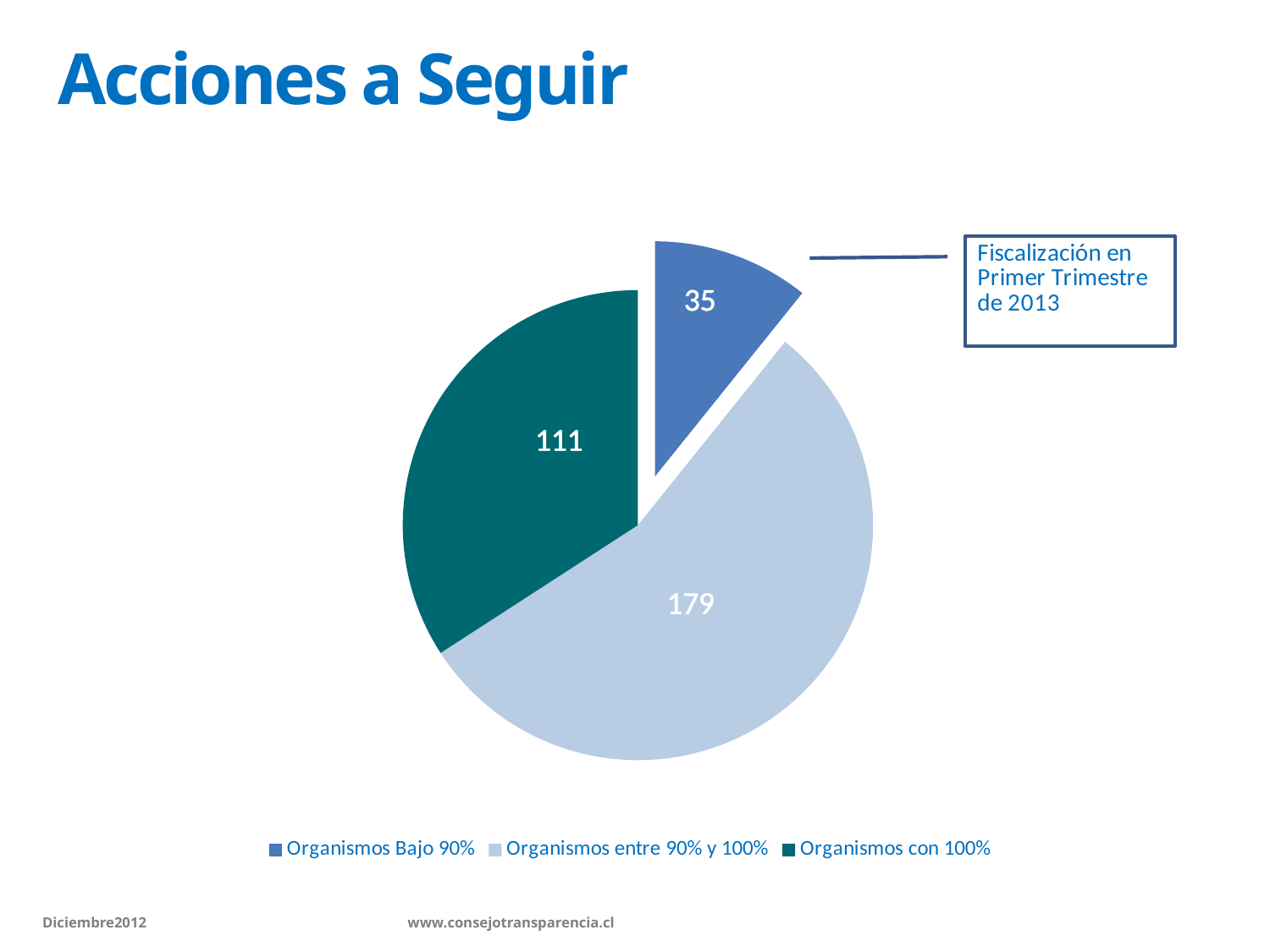
Which category has the largest slice of the pie? Organismos entre 90% y 100% Which is larger, the value for Organismos con 100% or the value for Organismos Bajo 90%? Organismos con 100% What does the callout box pointing to the Organismos Bajo 90% slice say? Fiscalización en Primer Trimestre de 2013 How many slices does the pie chart have? 3 What is the value for Organismos Bajo 90%? 35 Which category has the smallest slice of the pie? Organismos Bajo 90% What kind of chart is shown on the slide? pie chart How many entries does the legend list? 3 What is the value for Organismos entre 90% y 100%? 179 What is the difference between the values for Organismos entre 90% y 100% and Organismos con 100%? 68 What is the total of all three slices in the pie chart? 325 What is the value for Organismos con 100%? 111